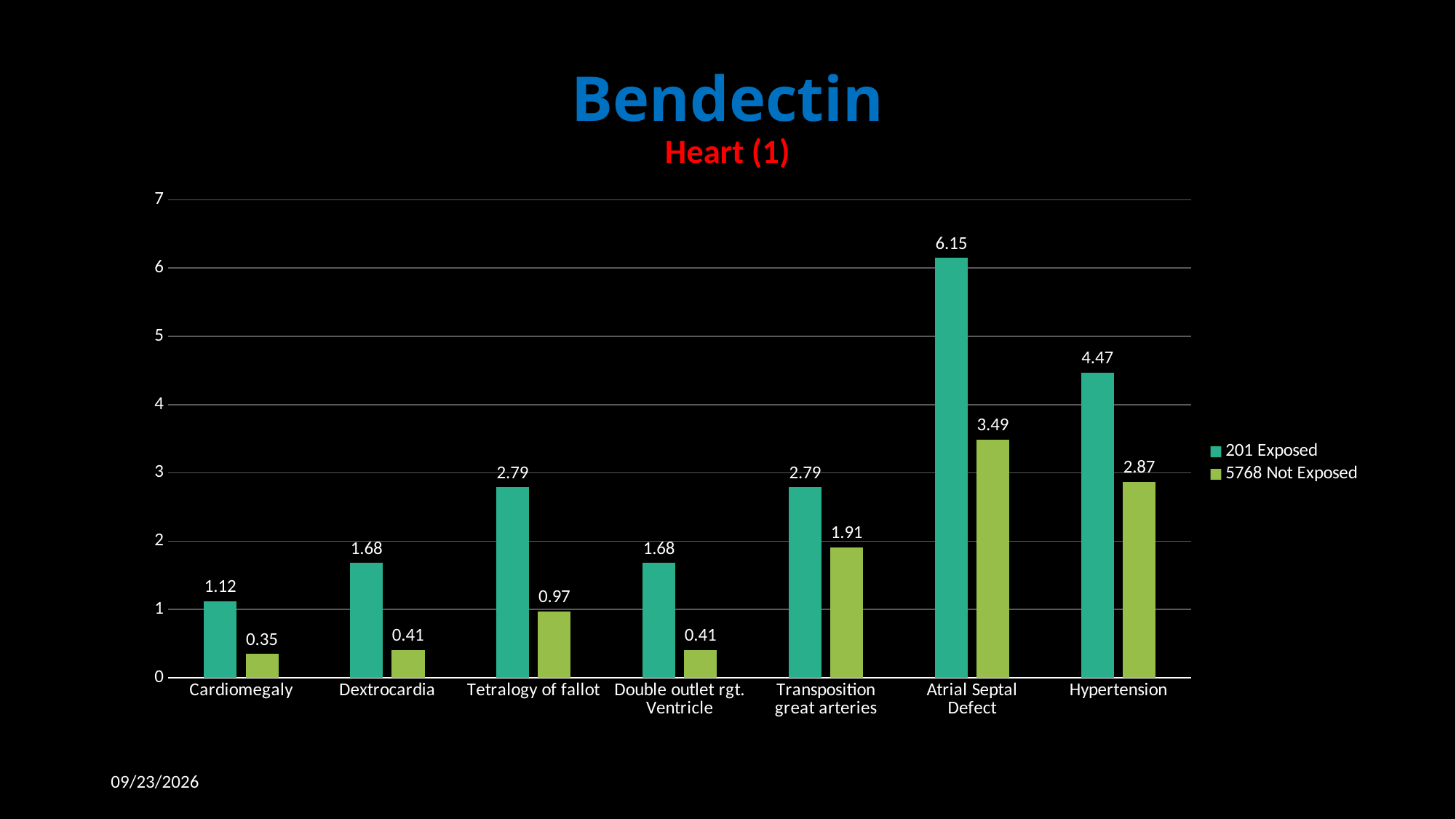
How many categories are shown on the x axis? 7 Is the 201 Exposed value for Hypertension greater or less than 4? greater What is the value for 201 Exposed for Atrial Septal Defect? 6.15 Which category has the lowest value for 5768 Not Exposed? Cardiomegaly How many series does the legend list? 2 Which is larger for Transposition great arteries: the 201 Exposed value or the 5768 Not Exposed value? 201 Exposed What is the subtitle shown in red below the chart title? Heart (1) What is the value for 5768 Not Exposed for Hypertension? 2.87 What is the value for 5768 Not Exposed for Tetralogy of fallot? 0.97 What is the difference between the 201 Exposed and 5768 Not Exposed values for Atrial Septal Defect? 2.66 Which category has the highest value for 201 Exposed? Atrial Septal Defect What kind of chart is shown on the slide? Bar chart